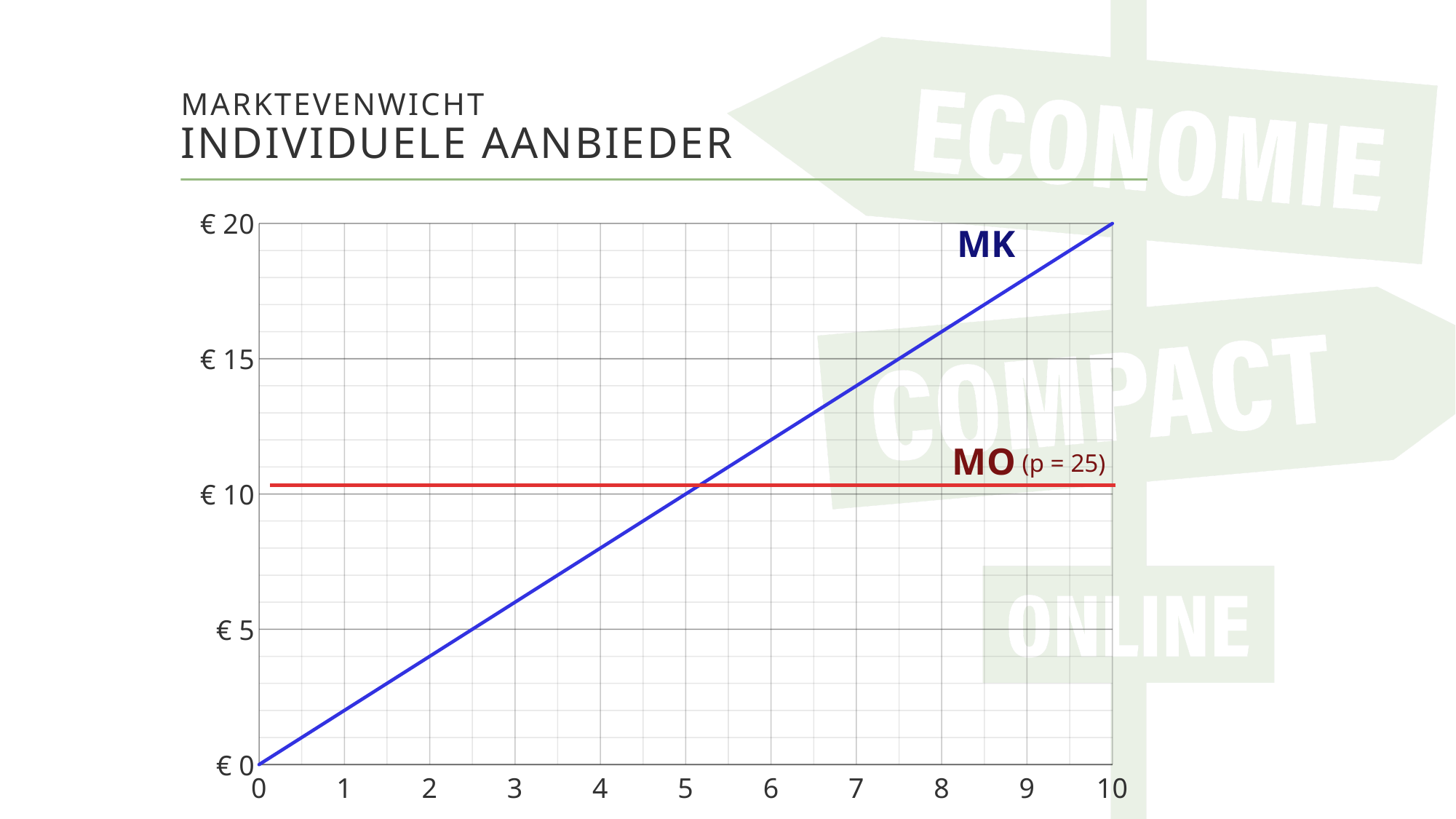
What is the value of the MK line at quantity 0? € 0 Is the value of the MO line greater or less than € 15? less Is the value of the MK line at quantity 8 greater or less than € 15? greater Is the value of the MO line greater or less than € 5? greater What colour is the MK line? blue At quantity 2, which line is higher, MK or MO? MO Does the MO line rise, fall or stay flat as quantity increases? stay flat What is the value of the MK line at quantity 10? € 20 What kind of chart is shown on the slide? line chart At quantity 8, which line is higher, MK or MO? MK Does the MK line rise or fall as quantity increases from 0 to 10? rise How many lines are plotted on the chart? 2